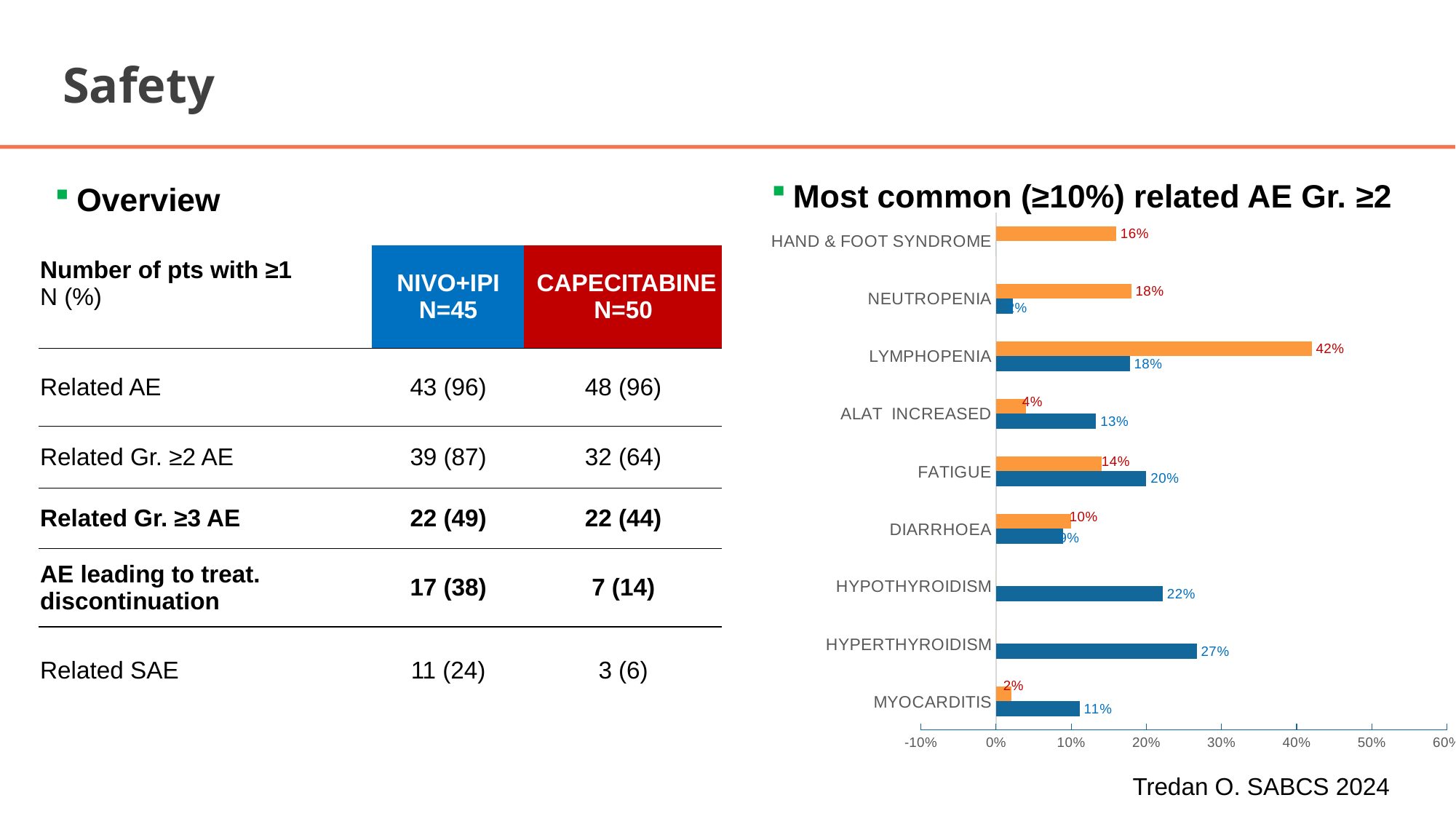
What is the value of the blue bar for HYPERTHYROIDISM? 27% What kind of chart is shown under 'Most common (≥10%) related AE Gr. ≥2'? Bar chart What is the value of the blue bar for ALAT INCREASED? 13% Which category has the longest orange bar? LYMPHOPENIA What is the value of the blue bar for MYOCARDITIS? 11% For FATIGUE, which bar is larger, the orange or the blue? Blue Which categories in the chart have only a blue bar and no orange bar? HYPOTHYROIDISM and HYPERTHYROIDISM What is the value of the orange bar for HAND & FOOT SYNDROME? 16% Is the blue bar for HYPOTHYROIDISM greater or less than 20%? greater What is the difference between the orange and blue bars for LYMPHOPENIA? 24 percentage points How many adverse event categories are listed on the y axis of the chart? 9 What is the value of the orange bar for LYMPHOPENIA? 42%